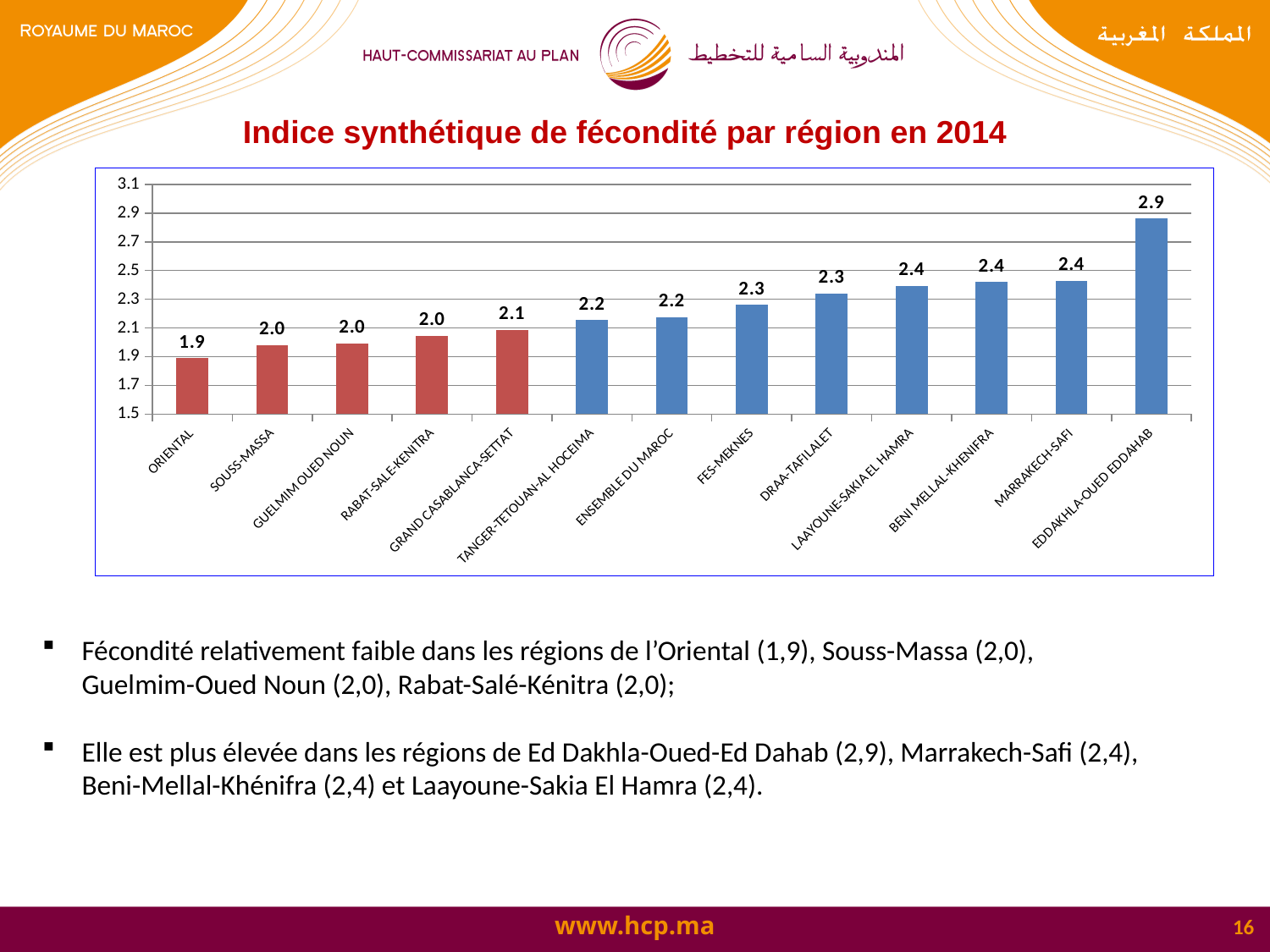
What is the value for ENSEMBLE DU MAROC? 2.2 Do the values rise or fall from left to right along the x axis? rise How many categories are shown on the x axis? 13 Which region has the lowest value? ORIENTAL What is the value for EDDAKHLA-OUED EDDAHAB? 2.9 What is the value for GRAND CASABLANCA-SETTAT? 2.1 What is the difference between the values for EDDAKHLA-OUED EDDAHAB and ORIENTAL? 1.0 What kind of chart is shown on the slide? bar chart Is the value for EDDAKHLA-OUED EDDAHAB greater or less than 2.7? greater Which region has the highest value? EDDAKHLA-OUED EDDAHAB Which is larger, the value for FES-MEKNES or the value for ORIENTAL? FES-MEKNES What is the value for ORIENTAL? 1.9